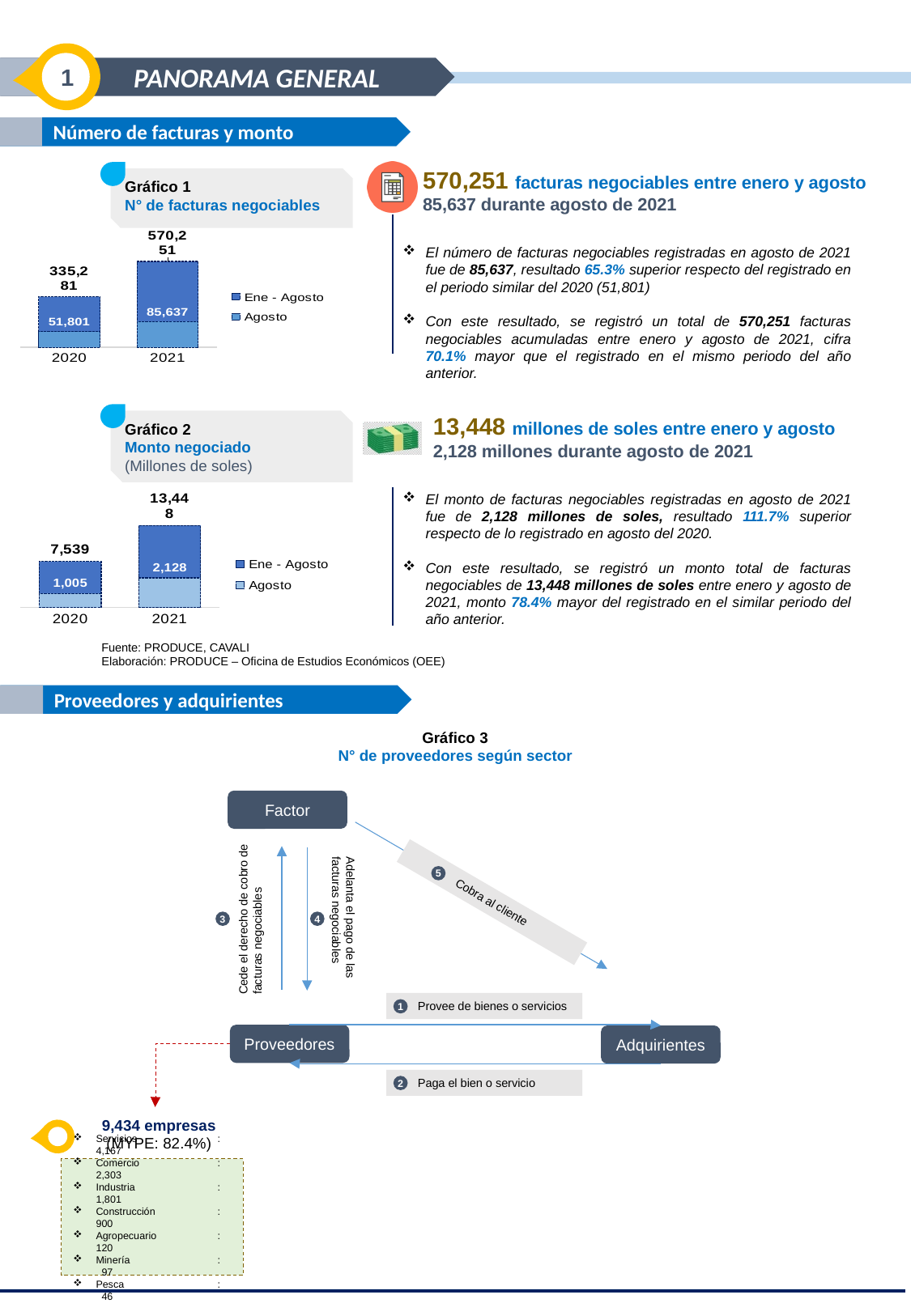
In Gráfico 1 (N° de facturas negociables), what is the Ene - Agosto value for 2020? 335,281 In Gráfico 2 (Monto negociado), which year has the highest Ene - Agosto value? 2021 In Gráfico 1 (N° de facturas negociables), which year has the larger Agosto value, 2020 or 2021? 2021 What kind of chart is Gráfico 1 (N° de facturas negociables)? Bar chart In Gráfico 2 (Monto negociado), what is the Agosto value for 2021? 2,128 In what unit are the values of Gráfico 2 (Monto negociado) expressed, according to its title? Millones de soles In Gráfico 1 (N° de facturas negociables), what is the difference between the Agosto values for 2021 and 2020? 33,836 How many series does the legend of Gráfico 1 (N° de facturas negociables) list? 2 In Gráfico 2 (Monto negociado), what is the difference between the Ene - Agosto values for 2021 and 2020? 5,909 In Gráfico 1 (N° de facturas negociables), what is the value for Agosto in 2021? 85,637 In Gráfico 2 (Monto negociado), what is the Ene - Agosto value for 2020? 7,539 How many years (categories) are shown on the x axis of Gráfico 2 (Monto negociado)? 2